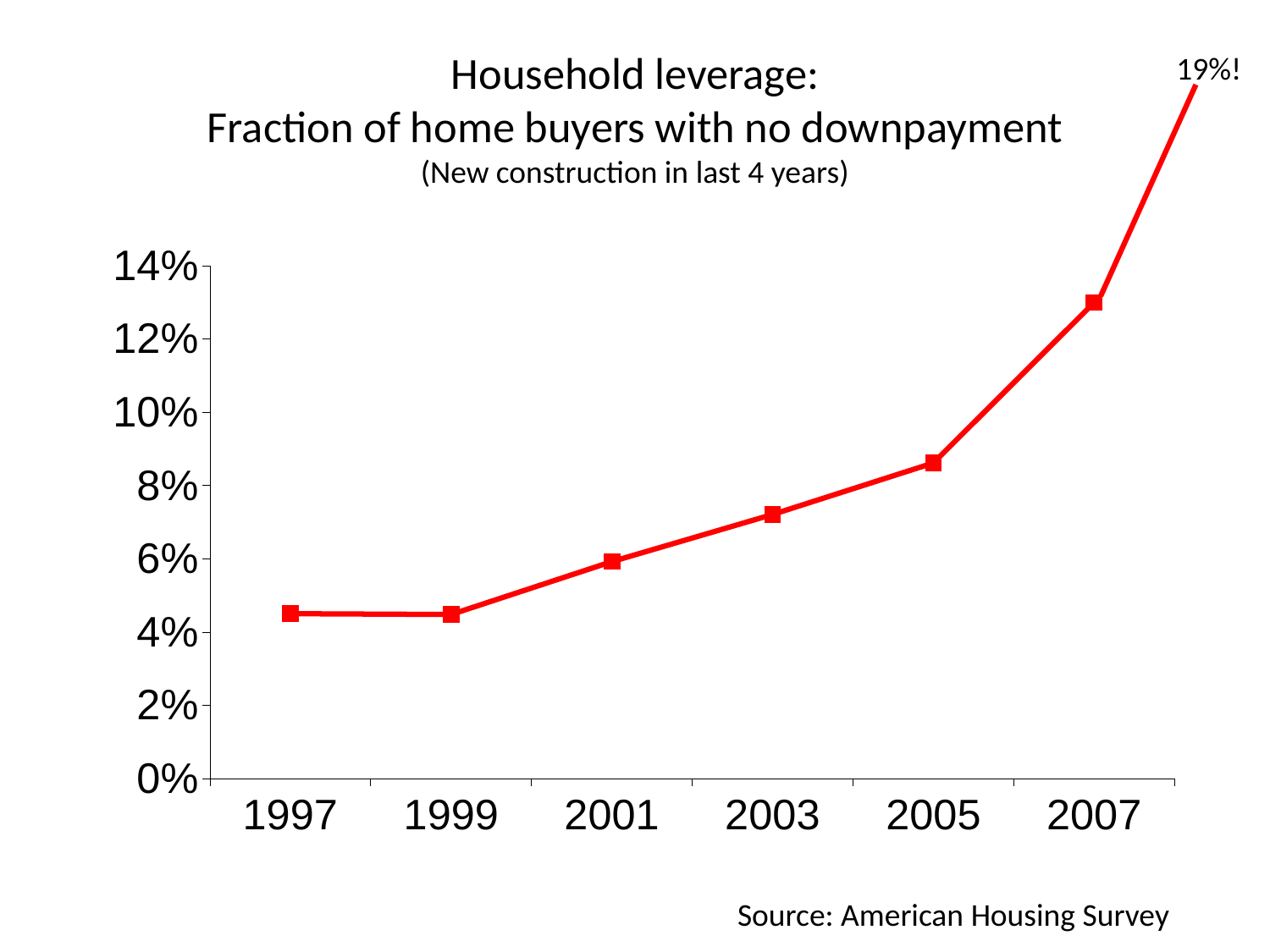
Is the value for 2005 greater or less than 8%? greater Do the values generally rise or fall from 1997 to 2007? rise What is the source cited for the chart? American Housing Survey Is the value for 2007 greater or less than 12%? greater How many years are labeled on the x axis? 6 What kind of chart is shown on the slide? line chart Is the value for 2001 greater or less than 8%? less Which year has the larger value, 1999 or 2003? 2003 Which year has the larger value, 2005 or 2007? 2007 Which labeled year on the x axis has the highest fraction of home buyers with no downpayment? 2007